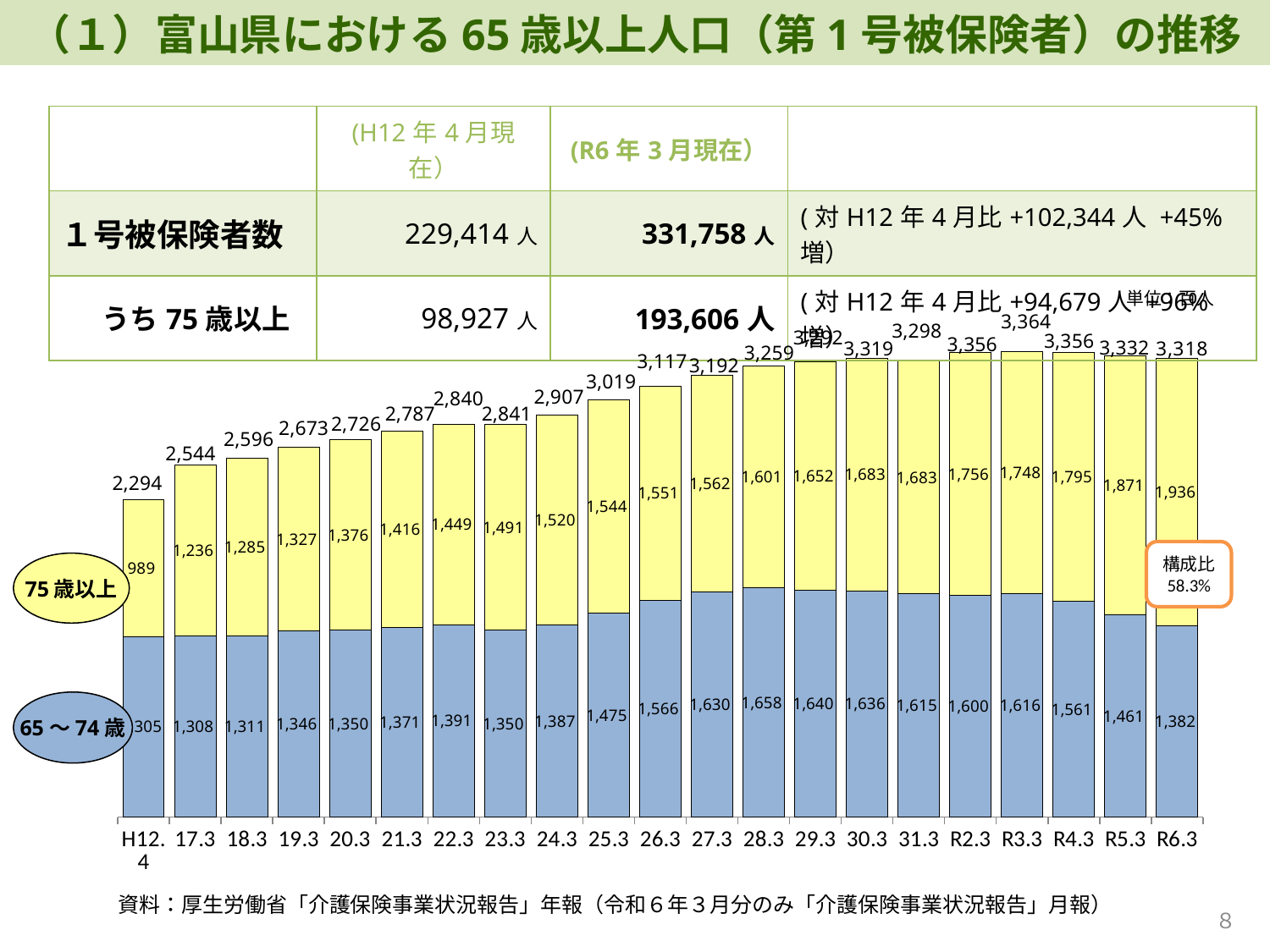
What kind of chart is shown on the slide? stacked bar chart For R6.3, which segment is larger: 75歳以上 or 65～74歳? 75歳以上 What is the value of the 65～74歳 segment for 28.3? 1,658 Which time point has the highest total bar value? R3.3 What 構成比 (share) is shown in the callout box next to the R6.3 bar? 58.3% What is the difference between the 75歳以上 value for R6.3 and the 75歳以上 value for 17.3? 700 How many series does the chart show (as labelled by the ovals on the left)? 2 Which time point has the highest 75歳以上 value? R6.3 What is the total shown above the bar for R3.3? 3,364 Which time point has the lowest total bar value? H12.4 What is the value of the 75歳以上 segment for R6.3? 1,936 How many time points (bars) are plotted along the x axis? 21